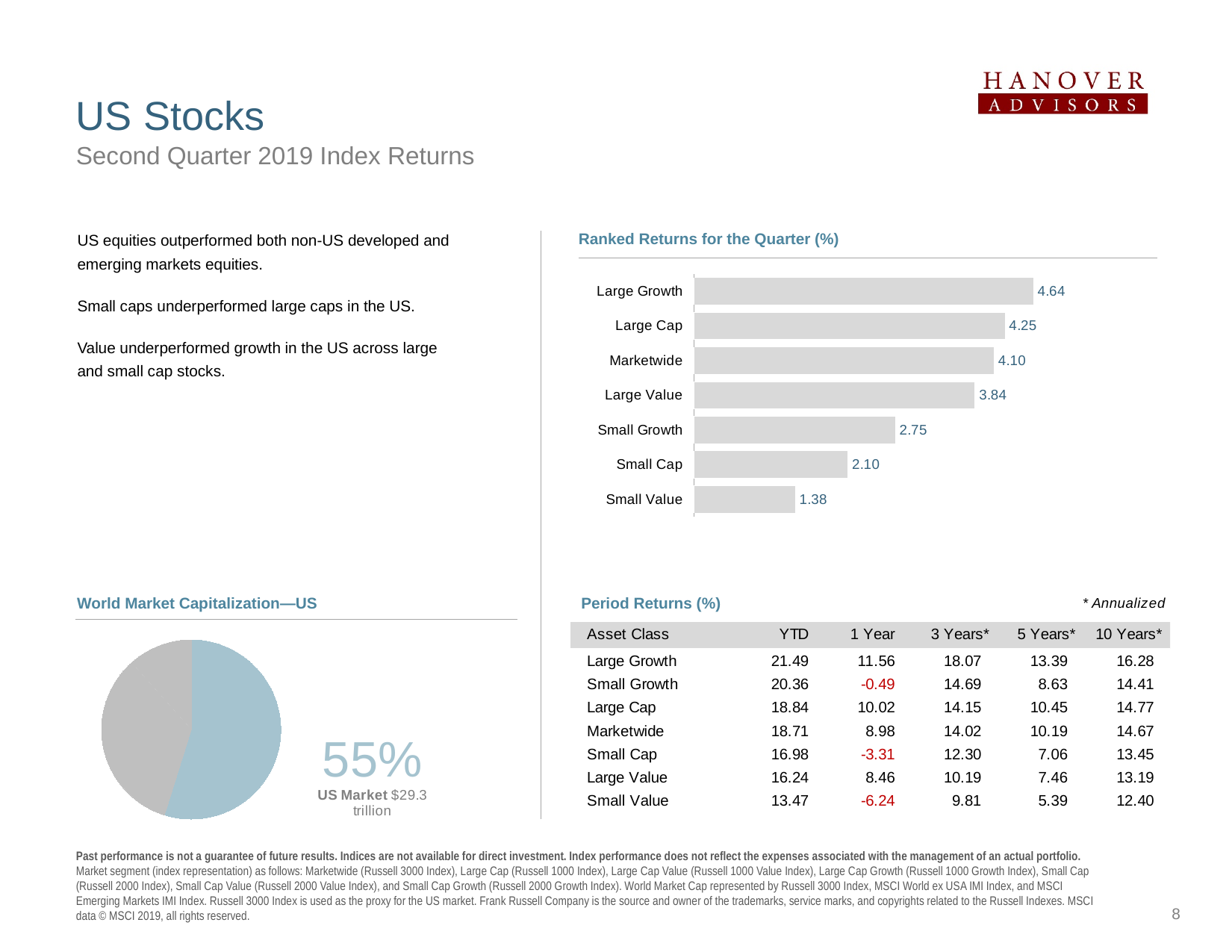
In the 'Ranked Returns for the Quarter (%)' chart, what is the value for Marketwide? 4.10 In the 'World Market Capitalization—US' pie chart, what share does the US Market represent? 55% In the 'Ranked Returns for the Quarter (%)' chart, which category has the highest value? Large Growth In the 'Ranked Returns for the Quarter (%)' chart, what is the difference between Large Value and Small Value? 2.46 In the 'Ranked Returns for the Quarter (%)' chart, which category has the lowest value? Small Value How many categories are shown in the 'Ranked Returns for the Quarter (%)' chart? 7 In the 'Ranked Returns for the Quarter (%)' chart, what is the difference between Large Cap and Small Cap? 2.15 In the 'Ranked Returns for the Quarter (%)' chart, what is the value for Large Growth? 4.64 What kind of chart is 'Ranked Returns for the Quarter (%)'? Bar chart What kind of chart is 'World Market Capitalization—US'? Pie chart In the 'Ranked Returns for the Quarter (%)' chart, what is the value for Small Cap? 2.10 In the 'Ranked Returns for the Quarter (%)' chart, which is larger, Small Growth or Large Value? Large Value